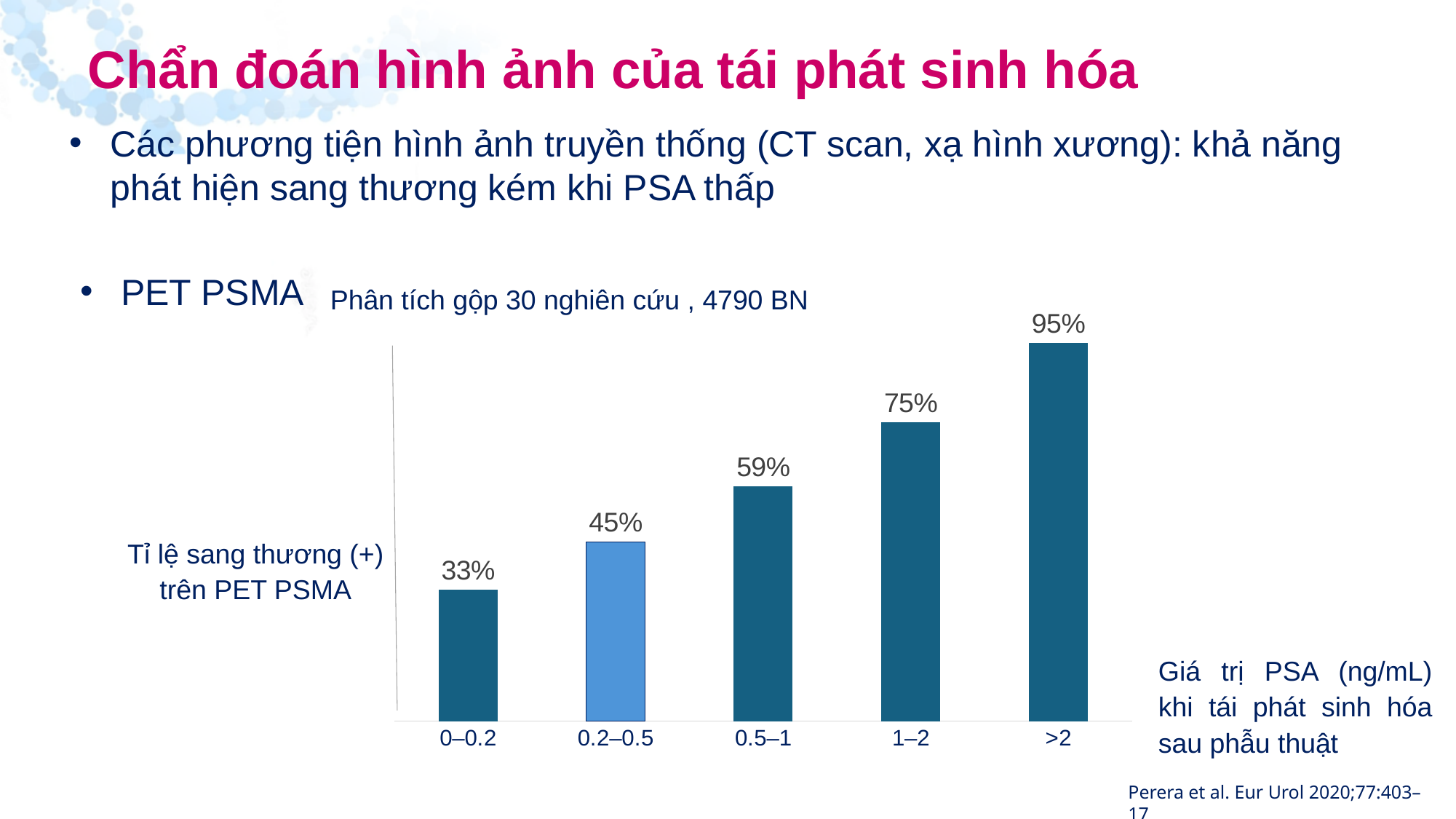
Do the positive lesion rates rise or fall as the PSA value increases along the x axis? Rise What is the PET PSMA positive lesion rate for the PSA range 0.5–1 ng/mL? 59% Which PSA range has the lowest PET PSMA positive lesion rate? 0–0.2 What is the PET PSMA positive lesion rate for the PSA range 1–2 ng/mL? 75% How many PSA ranges are shown on the x axis of the chart? 5 What is the PET PSMA positive lesion rate for the PSA range 0–0.2 ng/mL? 33% Which has a higher positive lesion rate: PSA 0.2–0.5 or PSA 0.5–1? 0.5–1 What kind of chart is shown on the slide? Bar chart What is the PET PSMA positive lesion rate for the PSA range 0.2–0.5 ng/mL? 45% What is the difference between the positive lesion rate for PSA >2 and for PSA 0–0.2? 62% What is the difference between the positive lesion rate for PSA 1–2 and for PSA 0.5–1? 16% Which PSA range has the highest PET PSMA positive lesion rate? >2